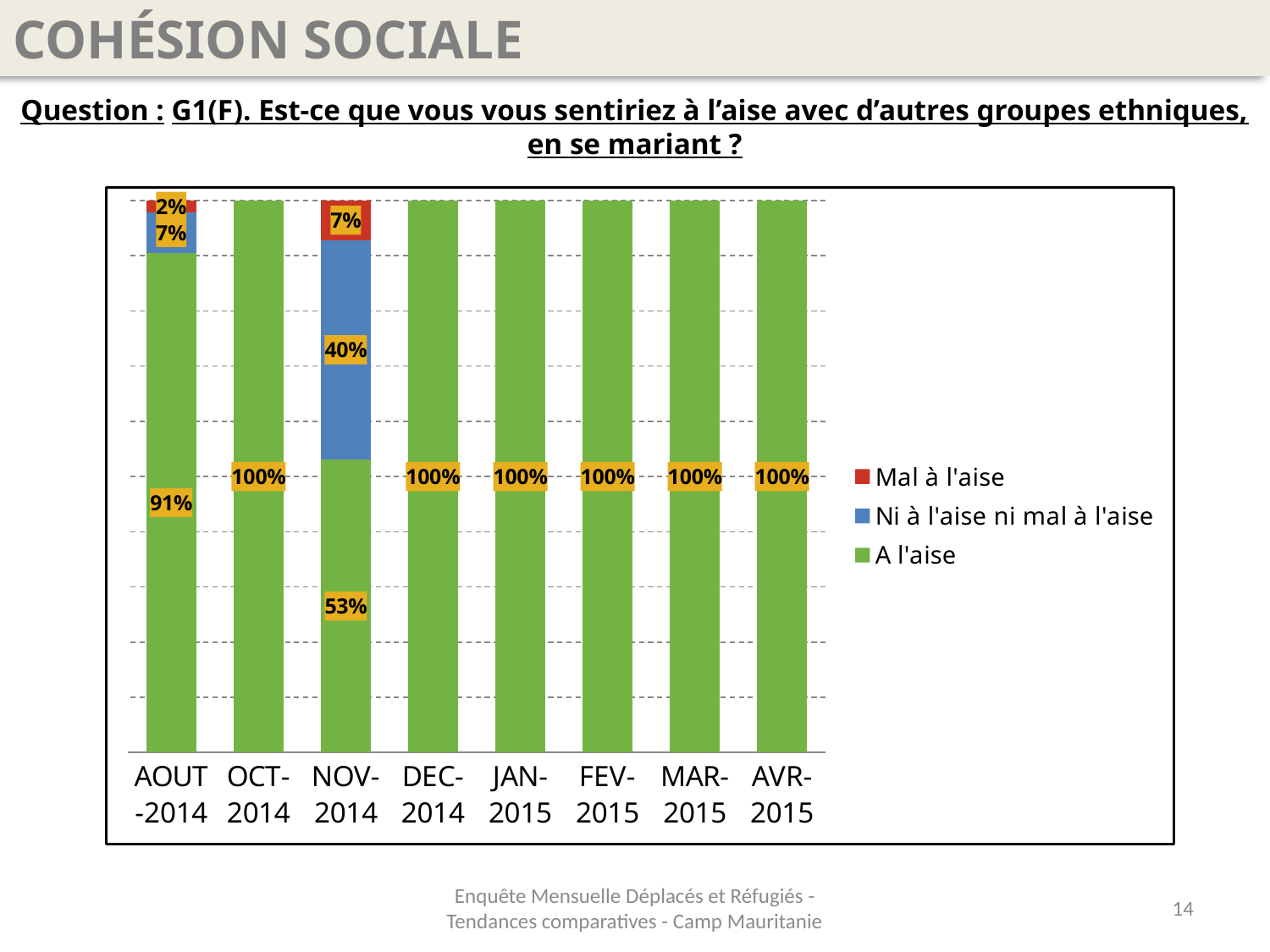
Which month has the lowest value for "A l'aise"? NOV-2014 Which legend entry is shown in green? A l'aise What is the value for "Mal à l'aise" in AOUT-2014? 2% How many series does the chart's legend list? 3 What is the value for "A l'aise" in FEV-2015? 100% Which is larger: the "Mal à l'aise" value in NOV-2014 or in AOUT-2014? NOV-2014 What kind of chart is shown on the slide? Stacked bar chart What is the value for "A l'aise" in AOUT-2014? 91% What is the difference between the "A l'aise" values for AOUT-2014 and NOV-2014? 38% How many months (categories) are shown on the x axis of the chart? 8 What is the value for "Ni à l'aise ni mal à l'aise" in NOV-2014? 40% What is the value for "A l'aise" in NOV-2014? 53%